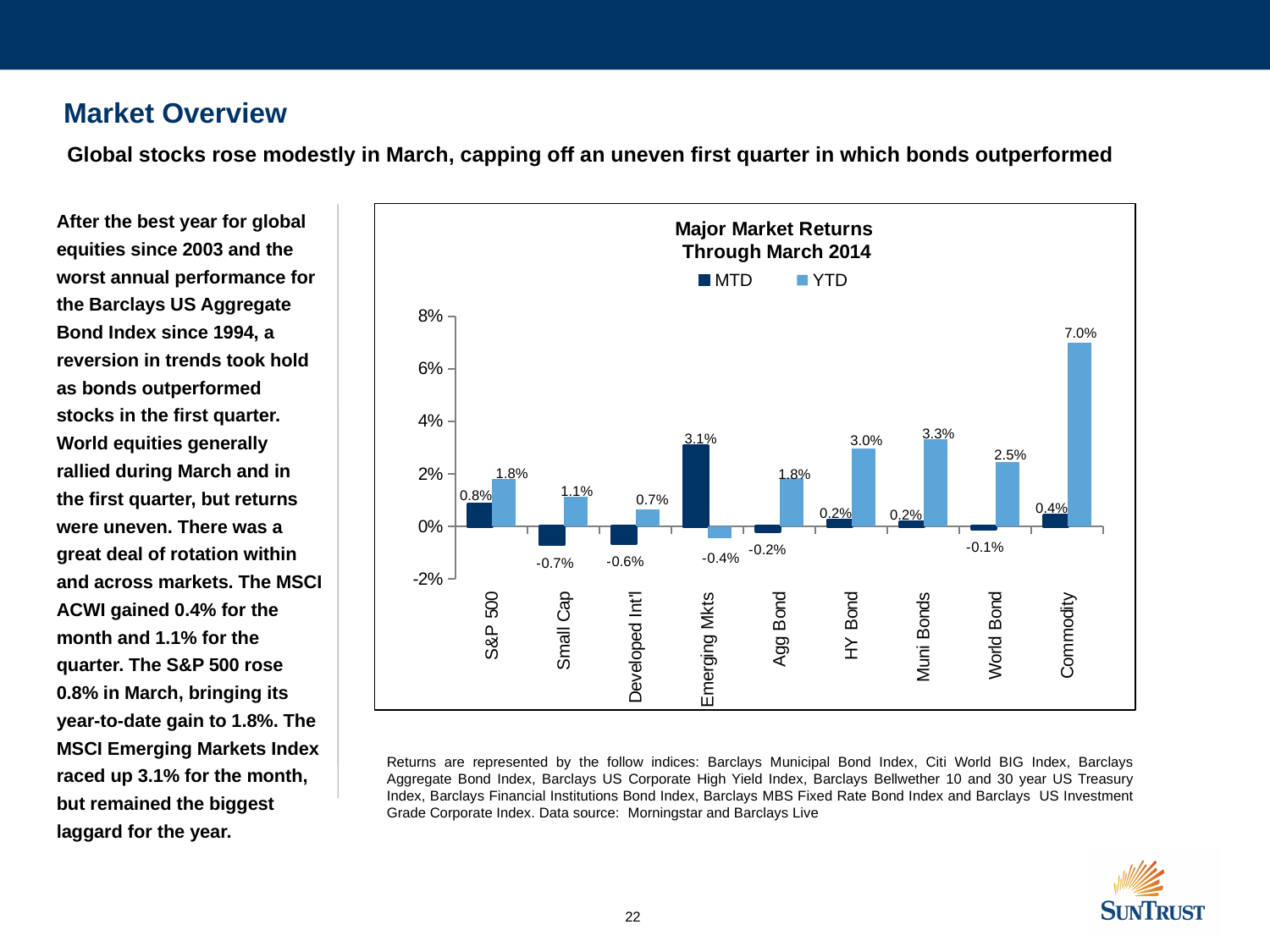
What is the title of the chart? Major Market Returns Through March 2014 What kind of chart is shown? Bar chart Which category has the lowest MTD value? Small Cap What is the YTD value for Small Cap? 1.1% What is the difference between the YTD and MTD values for S&P 500? 1.0% How many series does the legend list? 2 What is the YTD value for Commodity? 7.0% Which is larger, the YTD value for Muni Bonds or the YTD value for HY Bond? Muni Bonds Which category has the highest YTD value? Commodity How many categories are shown on the x axis? 9 What is the MTD value for Emerging Mkts? 3.1% What is the MTD value for Agg Bond? -0.2%